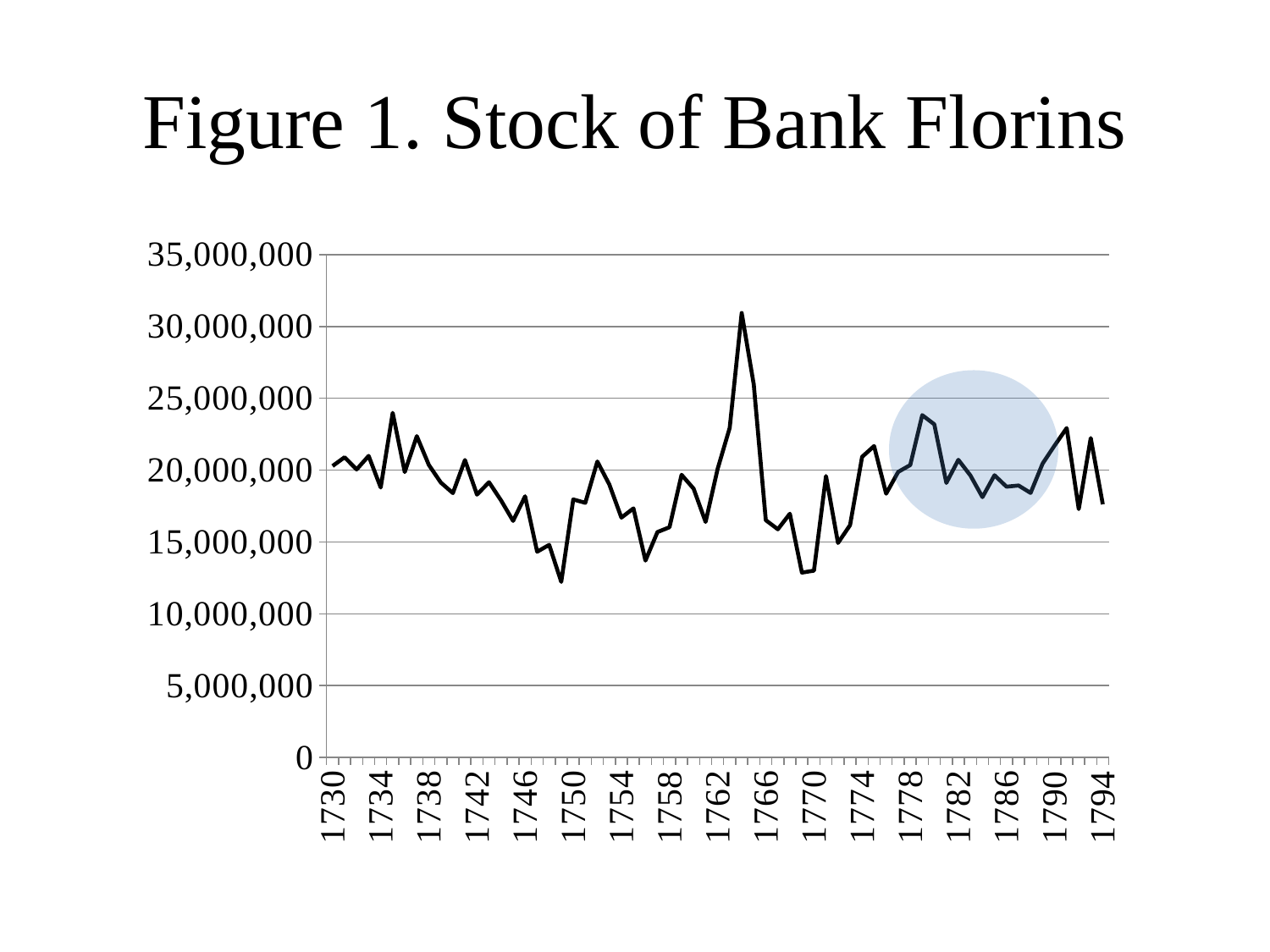
What kind of chart is shown on the slide? line chart What is the title of the chart? Figure 1. Stock of Bank Florins Is the value for 1750 greater or less than 15,000,000? greater How many year labels are shown on the x axis? 17 Is the value for 1770 greater or less than 15,000,000? less Which year has the larger value, 1750 or 1778? 1778 Is the value for 1794 greater or less than 20,000,000? less What is the highest value shown on the y axis? 35,000,000 Does the line rise or fall between 1770 and 1778? rise How many data series (lines) are plotted on the chart? 1